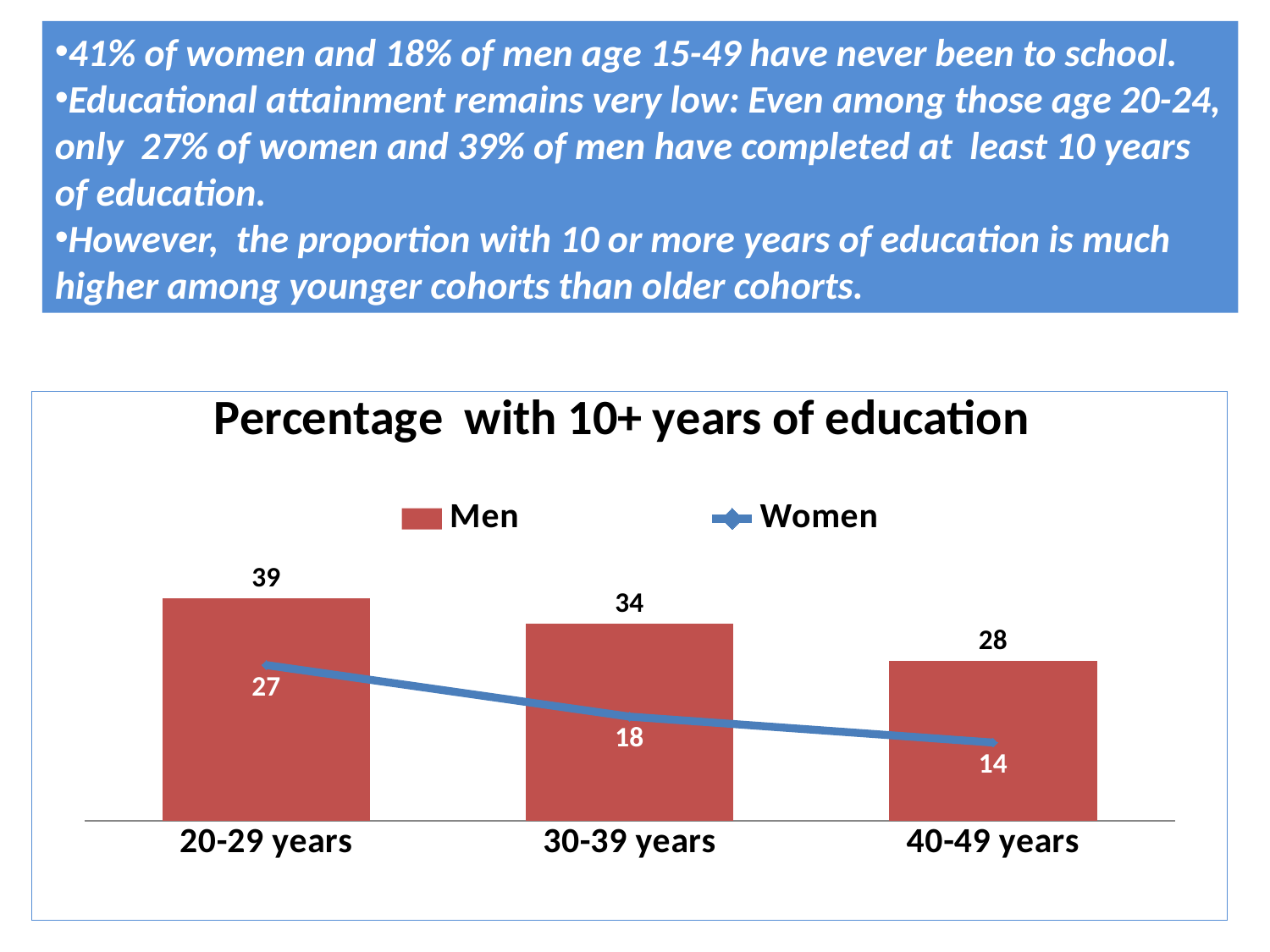
Which age group has the lowest value for Women? 40-49 years What is the title of the chart? Percentage with 10+ years of education How many series does the legend list? 2 Which is larger in the 40-49 years group, the value for Men or for Women? Men What is the value for Men in the 20-29 years group? 39 What is the difference between the Men and Women values in the 30-39 years group? 16 What is the value for Women in the 40-49 years group? 14 How many age groups are shown on the x axis? 3 What kind of chart is used for the Men series? Bar chart Which age group has the highest value for Men? 20-29 years Do the Women values rise or fall from the 20-29 years group to the 40-49 years group? Fall What is the value for Women in the 30-39 years group? 18